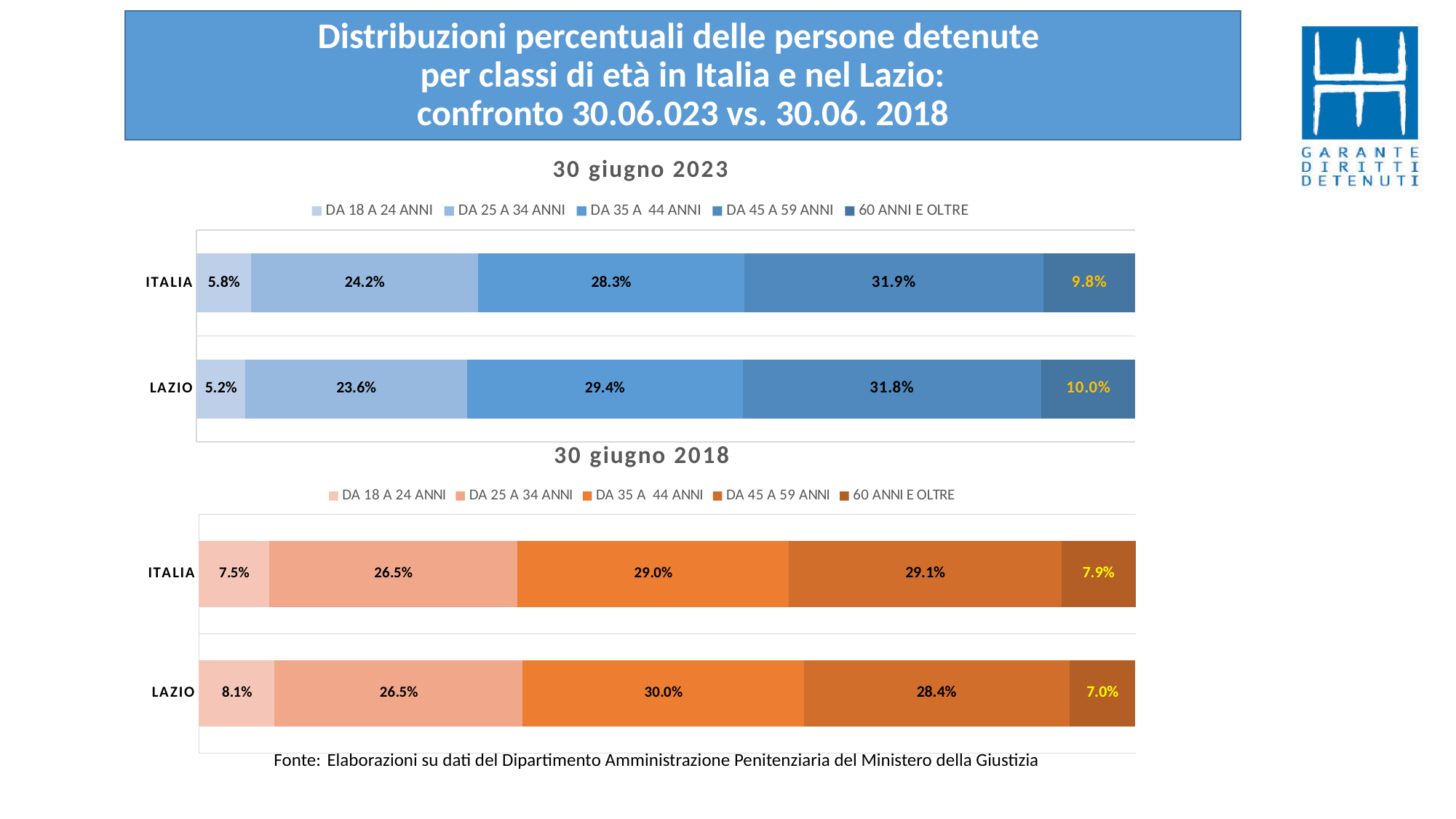
How many series does the legend of the '30 giugno 2023' chart list? 5 In the '30 giugno 2023' chart, what is the difference between the DA 25 A 34 ANNI values for ITALIA and LAZIO? 0.6% What is the title of the lower chart on the slide? 30 giugno 2018 In the '30 giugno 2023' chart, which age class has the highest share for ITALIA? DA 45 A 59 ANNI In the '30 giugno 2018' chart, which age class has the lowest share for LAZIO? 60 ANNI E OLTRE In the '30 giugno 2018' chart, what is the value for DA 18 A 24 ANNI for LAZIO? 8.1% In the '30 giugno 2023' chart, what is the value for DA 45 A 59 ANNI for ITALIA? 31.9% In the '30 giugno 2023' chart, what is the value for 60 ANNI E OLTRE for LAZIO? 10.0% In the '30 giugno 2018' chart, what is the value for DA 35 A 44 ANNI for ITALIA? 29.0% In the '30 giugno 2018' chart, which is larger: the DA 45 A 59 ANNI value for ITALIA or for LAZIO? ITALIA How many categories (bars) are shown in the '30 giugno 2018' chart? 2 What kind of chart is the '30 giugno 2023' chart? Stacked bar chart